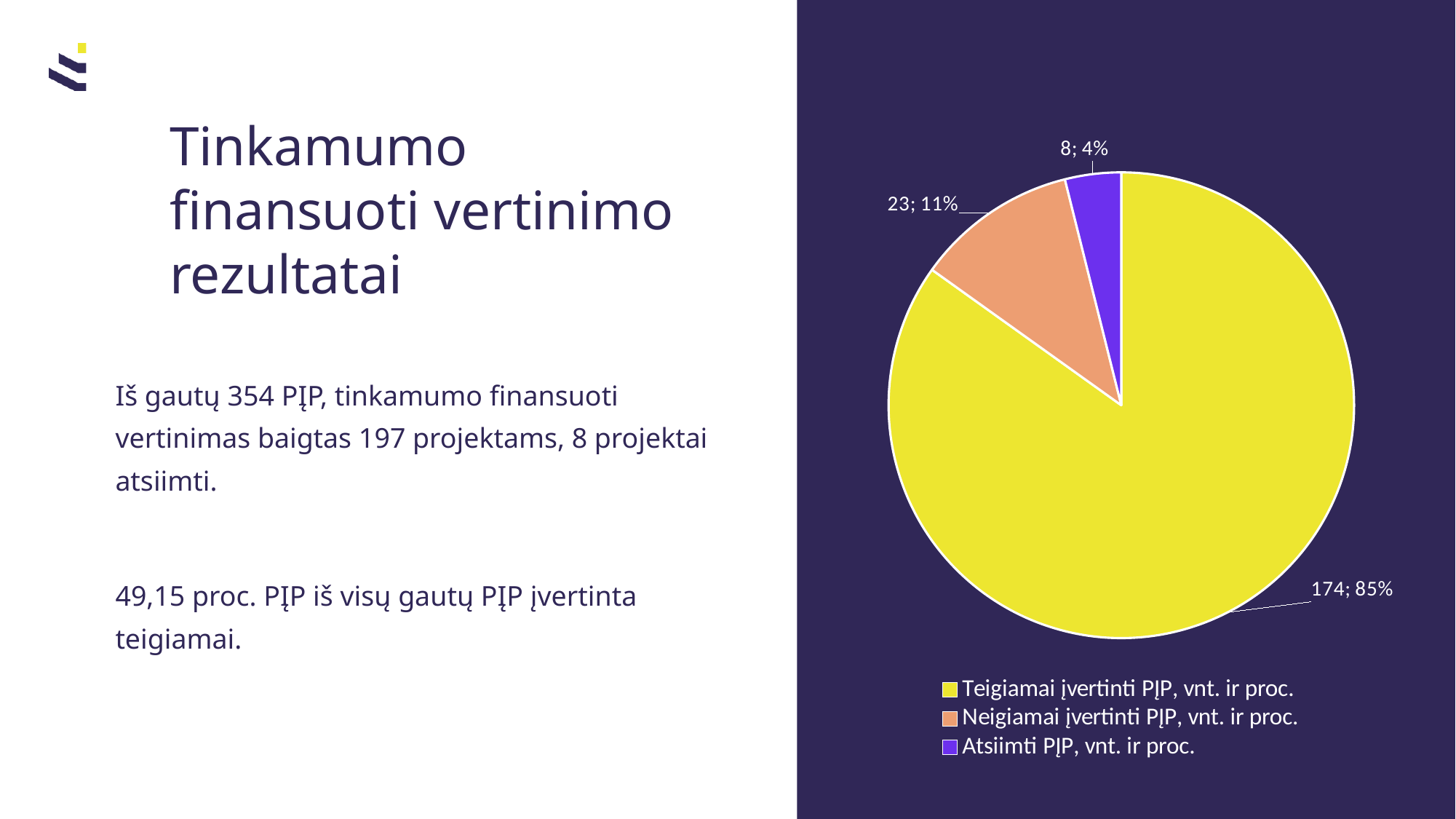
Which category has the smallest slice in the pie chart? Atsiimti PĮP, vnt. ir proc. Which colour is used for the "Atsiimti PĮP" slice in the pie chart? purple What is the count shown for "Neigiamai įvertinti PĮP" in the pie chart? 23 What kind of chart is shown on the slide? pie chart What share of the pie does "Teigiamai įvertinti PĮP" represent? 85% How many slices does the pie chart have? 3 What is the count shown for "Atsiimti PĮP" in the pie chart? 8 What share of the pie does "Neigiamai įvertinti PĮP" represent? 11% What is the difference between the counts for "Neigiamai įvertinti PĮP" and "Atsiimti PĮP"? 15 How many entries does the legend of the pie chart list? 3 Which category has the largest slice in the pie chart? Teigiamai įvertinti PĮP, vnt. ir proc. What is the count shown for "Teigiamai įvertinti PĮP" in the pie chart? 174